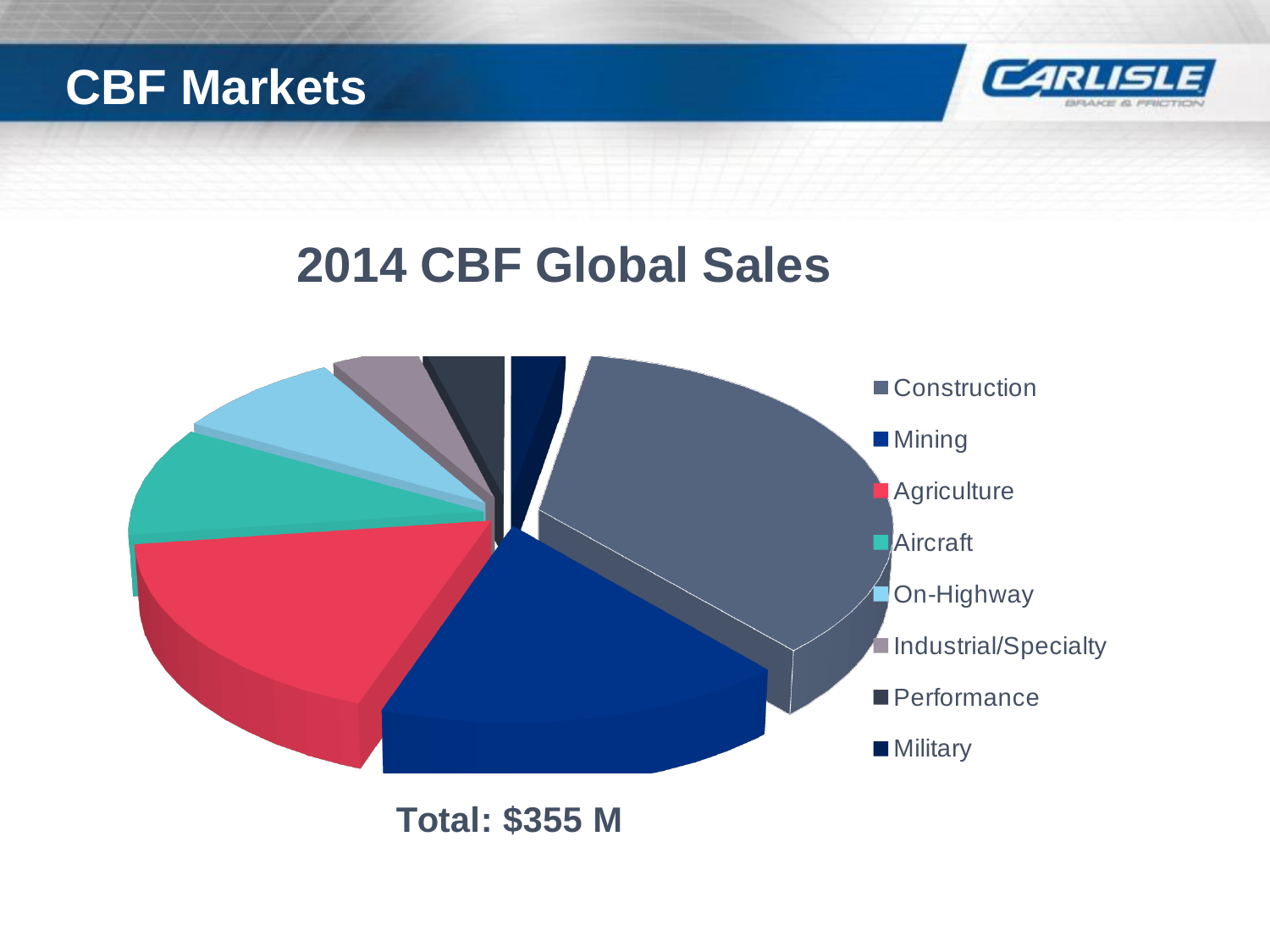
What kind of chart is shown on the slide? Pie chart What is the title of the pie chart? 2014 CBF Global Sales Which market has the largest slice of the 2014 CBF Global Sales pie? Construction Which slice is larger, Construction or Mining? Construction Which slice is larger, Aircraft or Military? Aircraft Which slice is larger, Performance or Military? Performance Which market has the smallest slice of the 2014 CBF Global Sales pie? Military How many categories does the pie chart's legend list? 8 What total is stated below the pie chart? $355 M